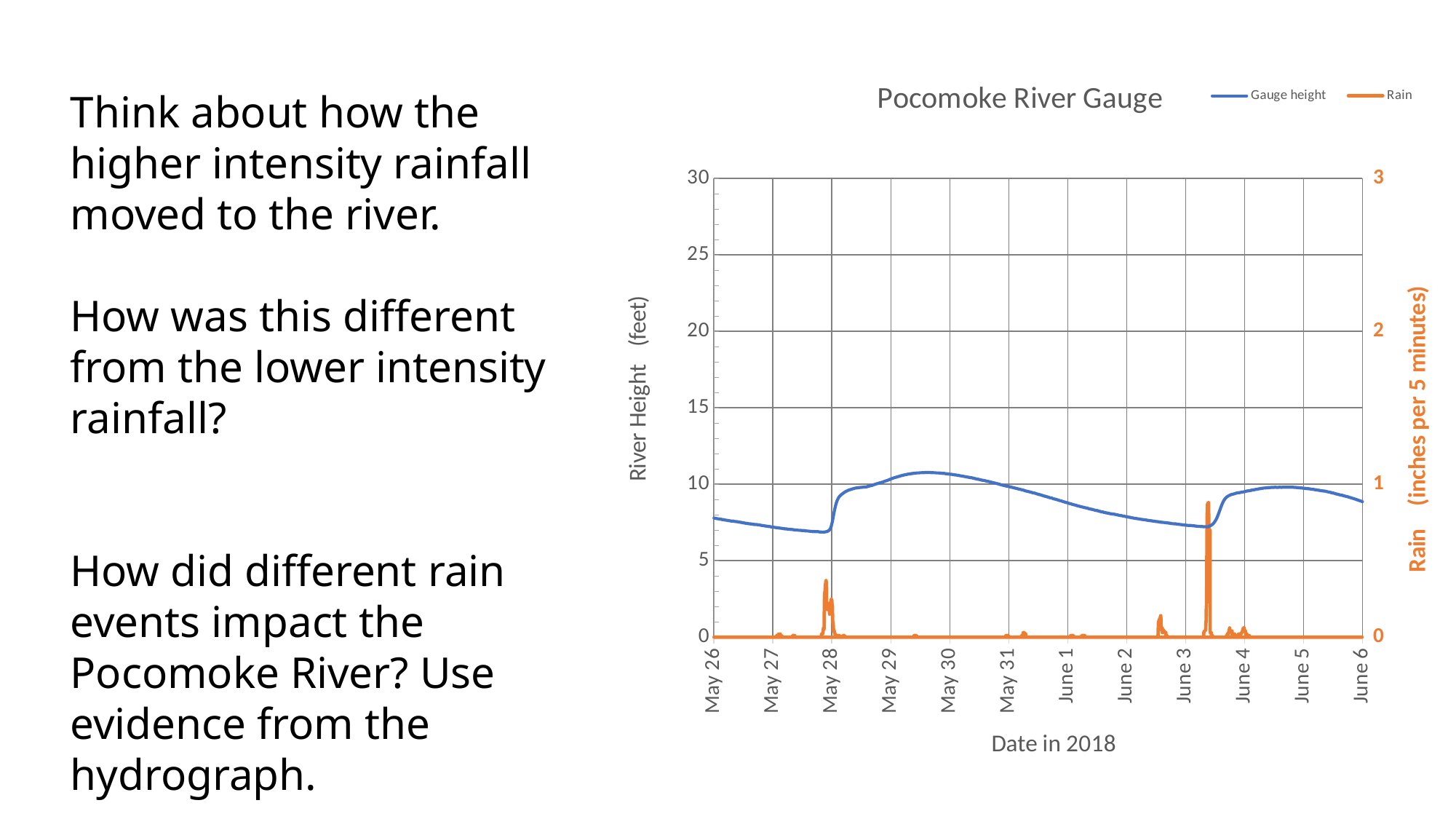
Is the highest Rain value on the chart greater or less than 1 inch per 5 minutes? less Which is larger, the Gauge height on May 30 or the Gauge height on June 3? May 30 How many series does the chart's legend list? 2 Is the Gauge height on May 26 greater or less than 10 feet? less Which rain event has the taller spike, the one around May 28 or the one just after June 3? The one just after June 3 What is the title of the chart? Pocomoke River Gauge Does the Gauge height rise or fall between May 30 and June 3? Fall What kind of chart is shown on the slide? Line chart Is the Gauge height on June 3 greater or less than 10 feet? less How many dates are labelled along the x axis? 12 What are the two series named in the legend? Gauge height and Rain